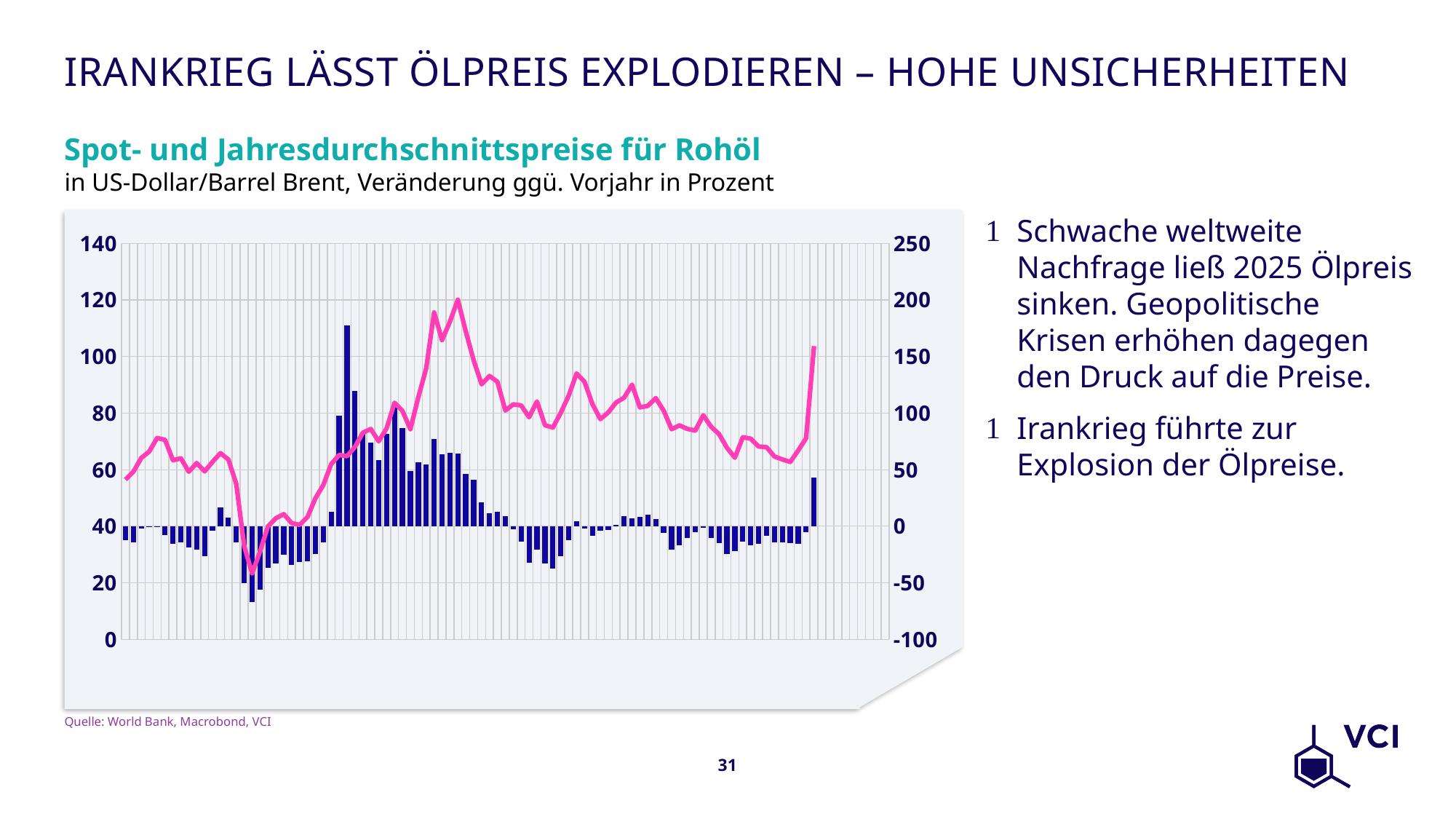
Is the peak value of the pink line greater or less than 100 on the left axis? greater What is the highest tick value shown on the left y-axis of the chart? 140 What is the highest tick value shown on the right y-axis of the chart? 250 Does the pink line rise or fall at the far right end of the chart? rise What is the title of the chart? Spot- und Jahresdurchschnittspreise für Rohöl Is the tallest blue bar greater or less than 150 on the right axis? greater What kind of chart is shown on the slide? A combined line and bar chart